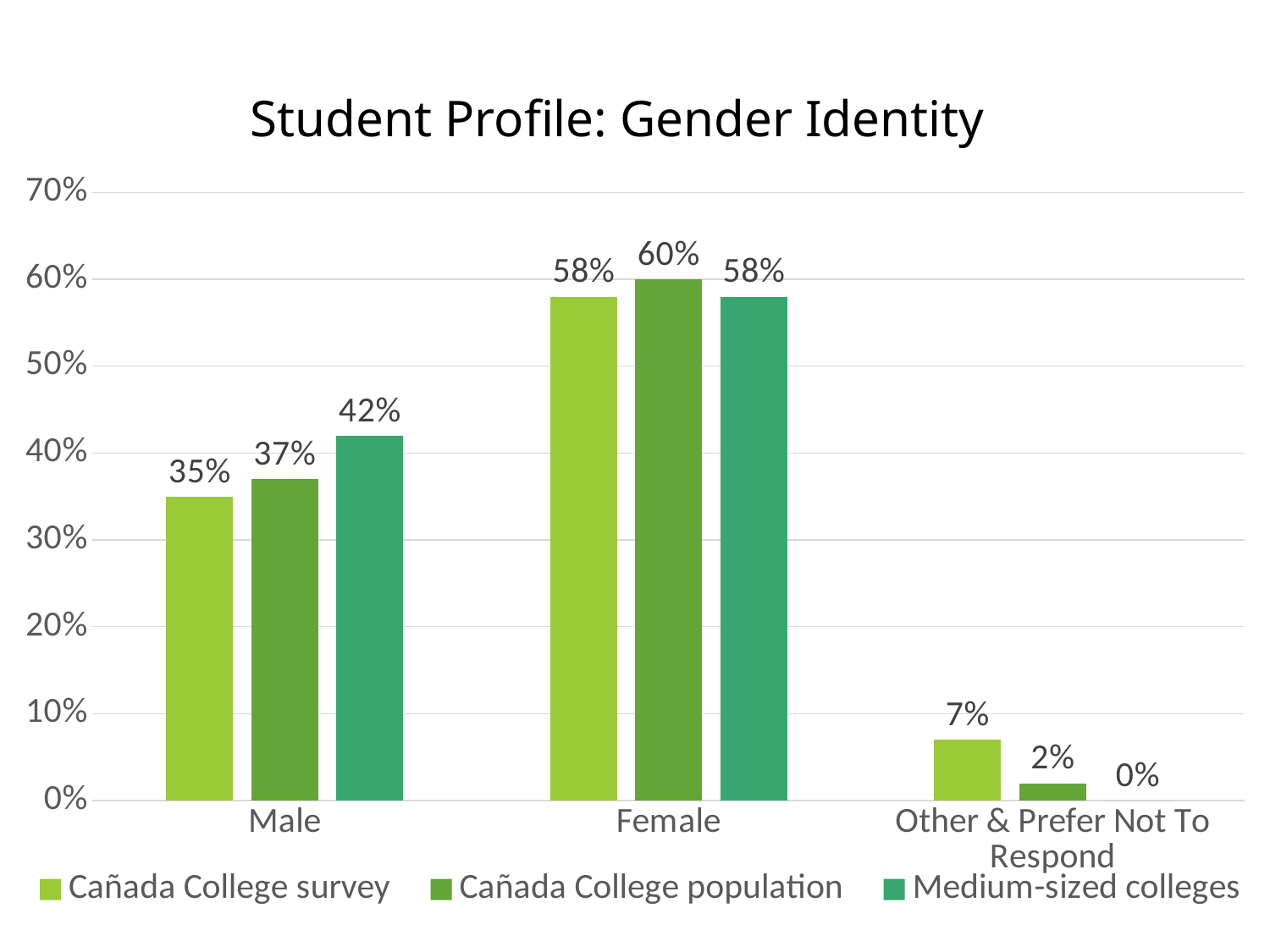
What is the value for Female in the Cañada College population series? 60% What is the value for Other & Prefer Not To Respond in the Medium-sized colleges series? 0% Which is larger for Other & Prefer Not To Respond: the Cañada College survey value or the Cañada College population value? Cañada College survey What kind of chart is shown on the slide? Bar chart How many categories are shown on the x axis? 3 What is the difference between the Medium-sized colleges value and the Cañada College survey value for Male? 7% What is the value for Male in the Medium-sized colleges series? 42% What is the title of the chart? Student Profile: Gender Identity Which category has the lowest value in the Cañada College population series? Other & Prefer Not To Respond Which category has the highest value in the Cañada College survey series? Female How many series does the legend list? 3 What is the value for Male in the Cañada College survey series? 35%